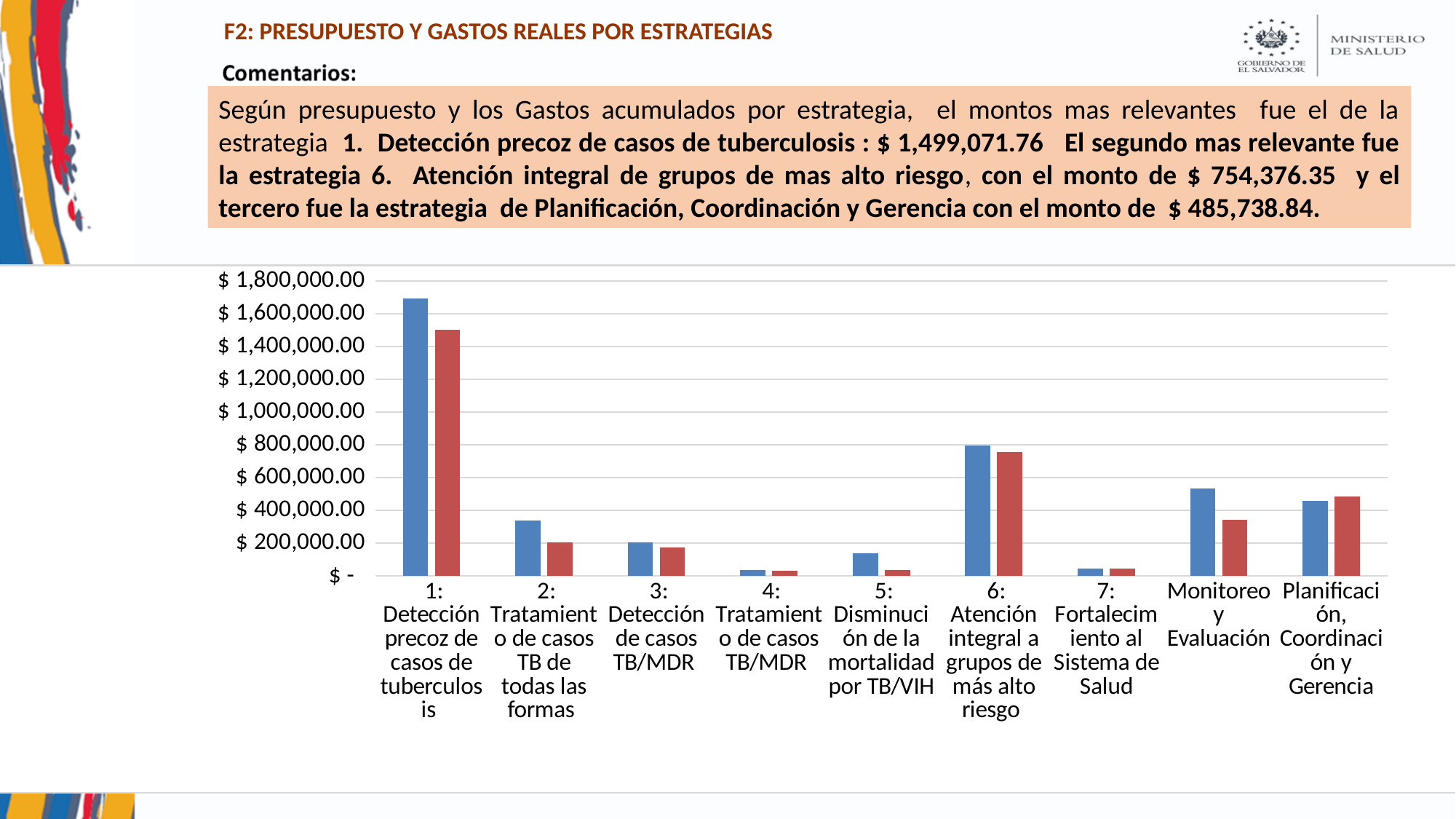
For 'Monitoreo y Evaluación', which bar is taller, the blue one or the red one? the blue one Which category has the tallest red bar? 1: Detección precoz de casos de tuberculosis Is the red bar for '6: Atención integral a grupos de más alto riesgo' greater or less than $ 800,000.00? less Which is taller: the blue bar for '6: Atención integral a grupos de más alto riesgo' or the blue bar for 'Monitoreo y Evaluación'? 6: Atención integral a grupos de más alto riesgo What kind of chart is shown on the slide? bar chart Is the red bar for '1: Detección precoz de casos de tuberculosis' greater or less than $ 1,600,000.00? less Is the blue bar for '1: Detección precoz de casos de tuberculosis' greater or less than $ 1,600,000.00? greater Which category has the tallest blue bar? 1: Detección precoz de casos de tuberculosis How many strategy categories are shown on the x axis of the chart? 9